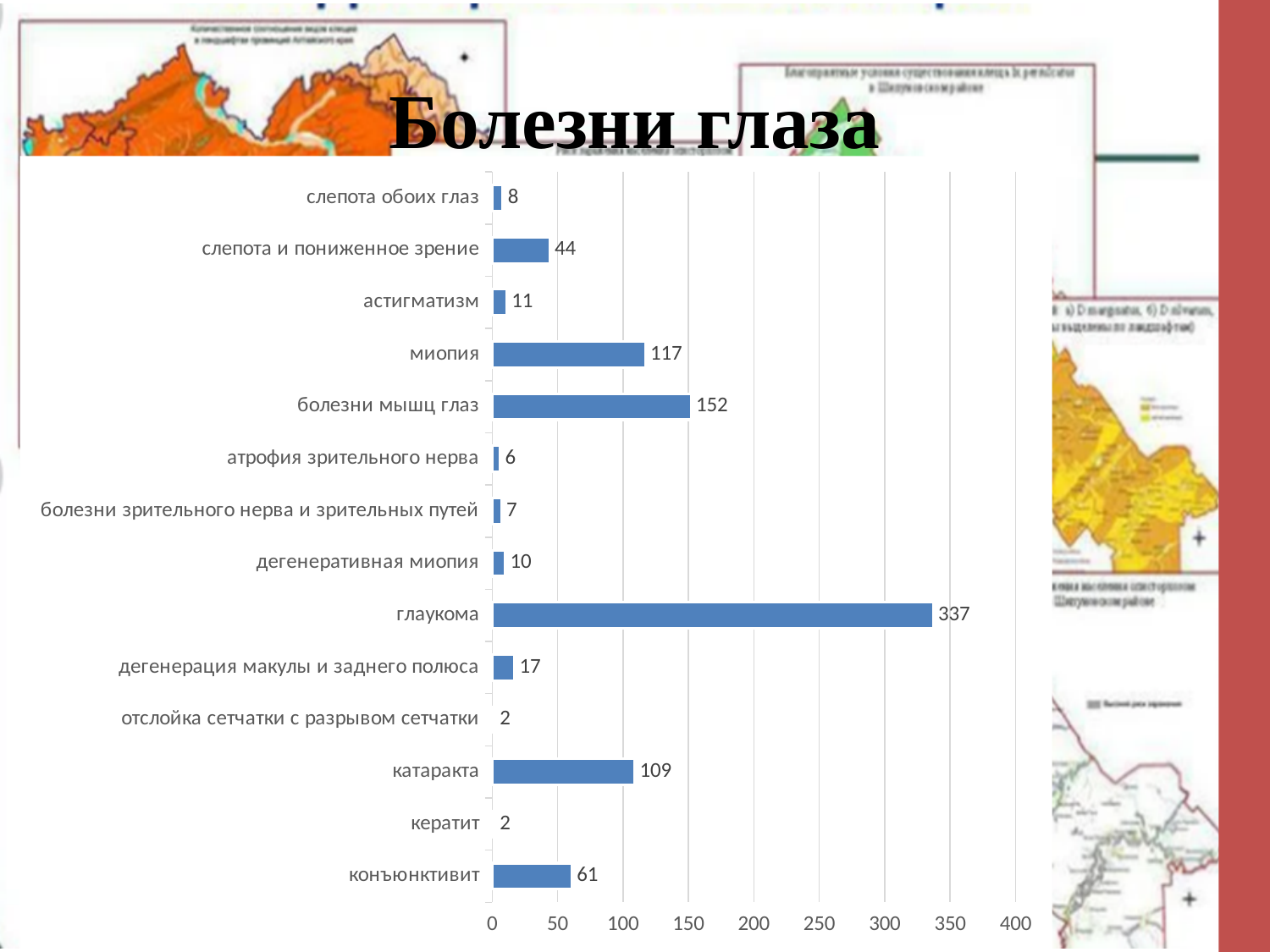
What is the value for конъюнктивит? 61 What is the title of the chart? Болезни глаза Which category has the highest value? глаукома What is the difference between the values for глаукома and болезни мышц глаз? 185 What is the value for дегенерация макулы и заднего полюса? 17 Is the value for глаукома greater or less than 300? greater What is the value for глаукома? 337 What is the value for болезни мышц глаз? 152 Which is larger, the value for миопия or the value for катаракта? миопия How many categories are plotted in the chart? 14 What type of chart is shown on the slide? bar chart What is the difference between the values for конъюнктивит and слепота и пониженное зрение? 17